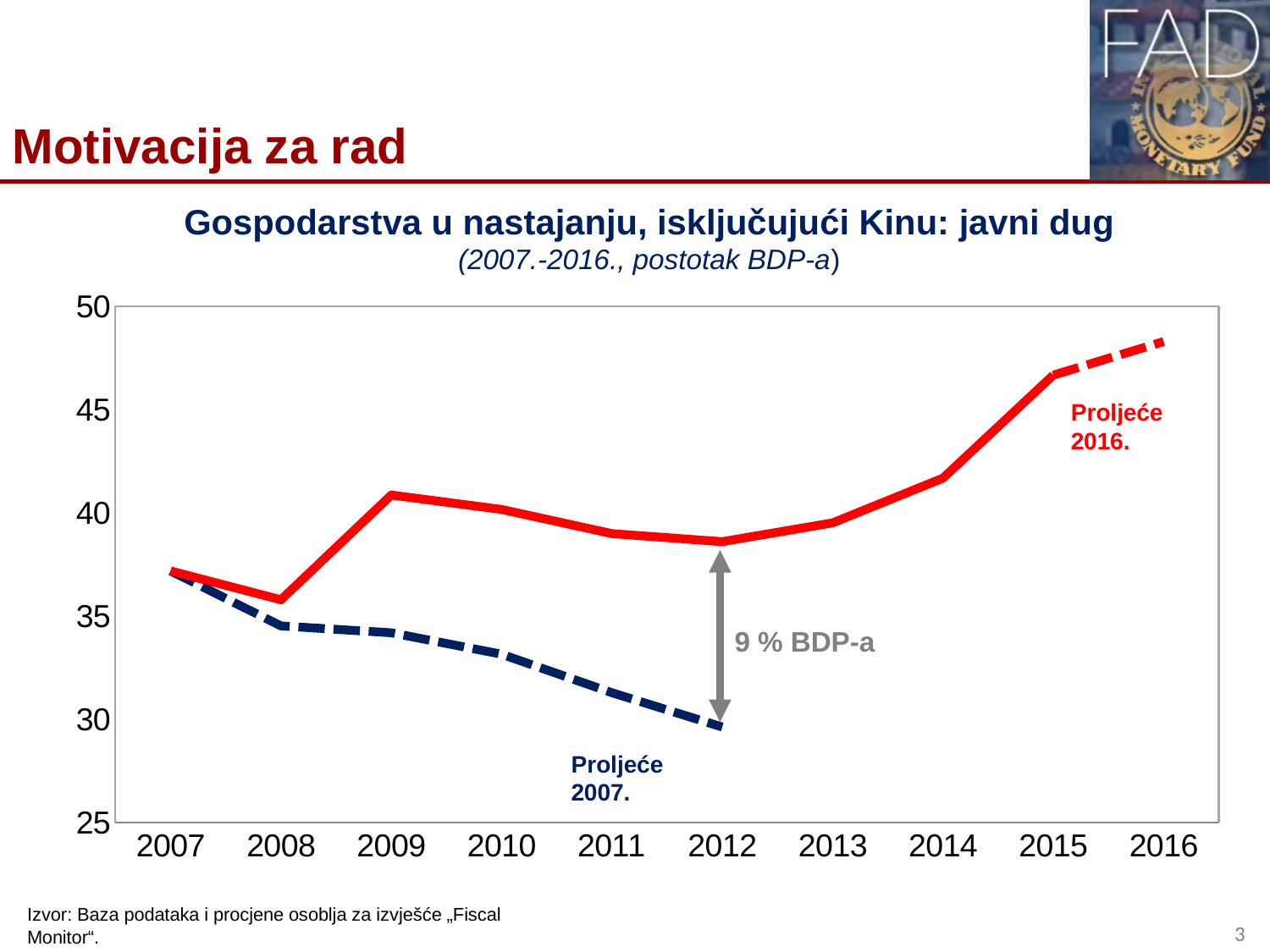
In 2012, which series has the higher value, Proljeće 2016. or Proljeće 2007.? Proljeće 2016. What is the title of the chart? Gospodarstva u nastajanju, isključujući Kinu: javni dug How many years are shown on the x axis of the chart? 10 Is the value of the Proljeće 2016. series in 2015 greater or less than 45? greater Is the value of the Proljeće 2016. series in 2012 greater or less than 40? less Does the Proljeće 2007. series rise or fall from 2007 to 2012? fall Is the value of the Proljeće 2007. series in 2011 greater or less than 35? less In which year does the Proljeće 2016. series reach its highest value? 2016 What is the labelled gap between the Proljeće 2016. and Proljeće 2007. lines in 2012? 9 % BDP-a What are the names of the two series plotted on the chart? Proljeće 2016. and Proljeće 2007. What kind of chart is shown on the slide? line chart How many series are plotted on the chart? 2